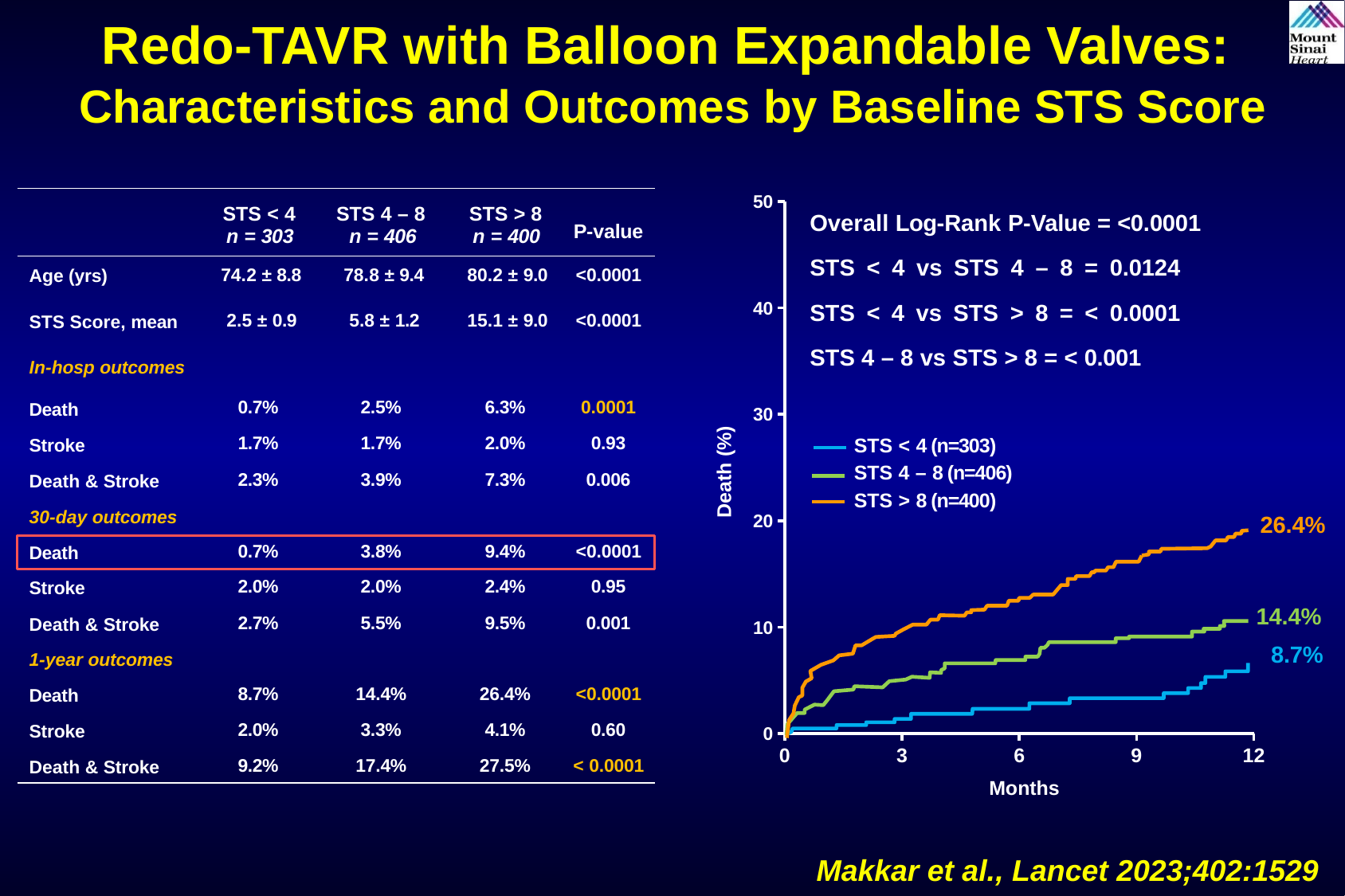
What kind of chart is shown on the right side of the slide? line chart In the Death (%) chart, which group has the highest death rate at 12 months? STS > 8 In the Death (%) chart, which group has the lowest death rate at 12 months? STS < 4 In the Death (%) chart, which group has a higher death rate at 12 months, STS 4 – 8 or STS < 4? STS 4 – 8 In the Death (%) chart, what is the 1-year death rate labelled for the STS 4 – 8 group? 14.4% In the Death (%) chart, what is the difference between the 12-month death rates of the STS > 8 and STS < 4 groups? 17.7% How many series does the legend of the Death (%) chart list? 3 In the Death (%) chart, what is the overall log-rank P-value shown? <0.0001 In the Death (%) chart, what is the 1-year death rate labelled for the STS > 8 group? 26.4% In the Death (%) chart, do the death curves rise or fall as months increase? rise In the Death (%) chart, what is the 1-year death rate labelled for the STS < 4 group? 8.7%